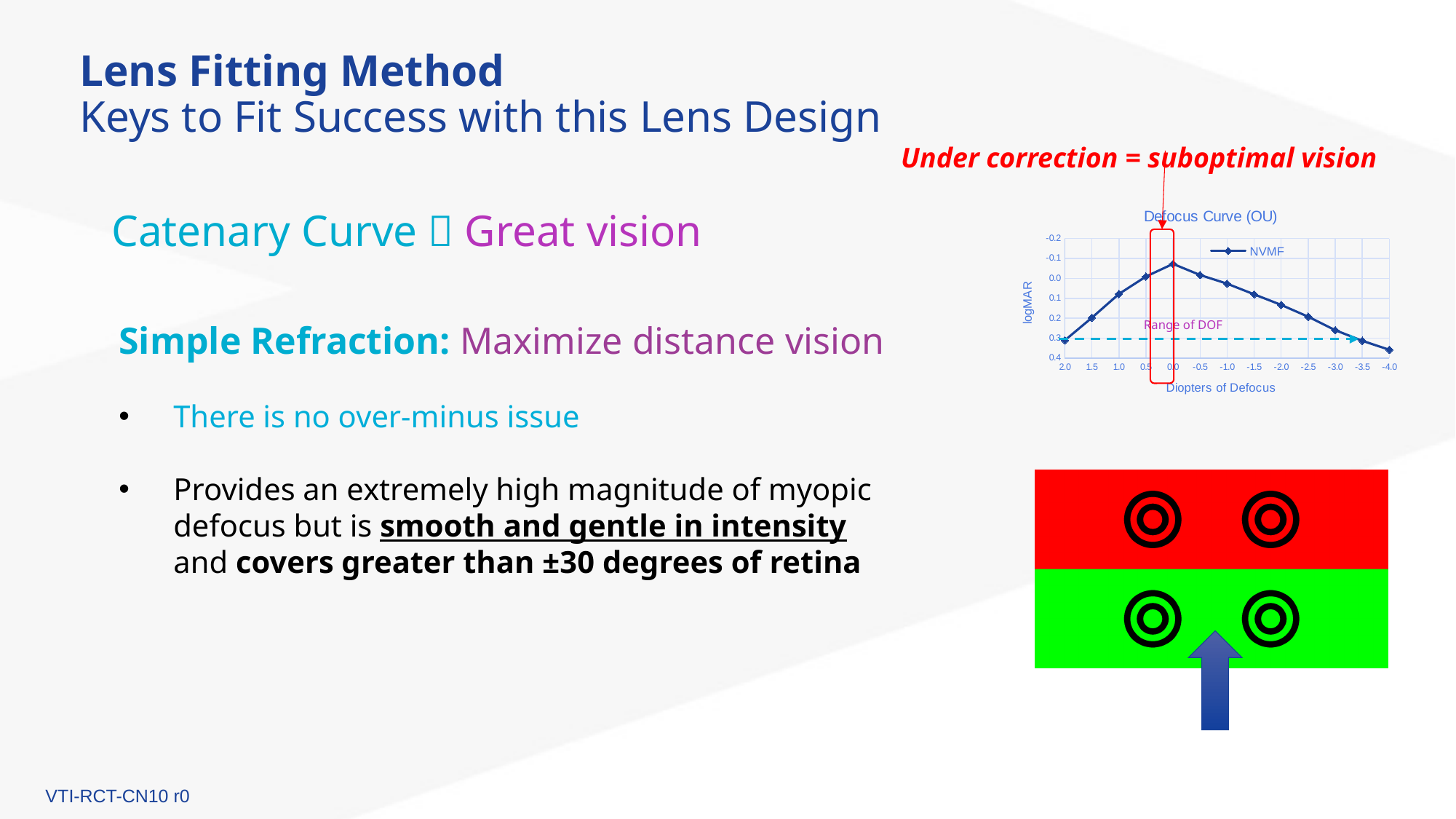
Which has the larger logMAR value on the NVMF line: -1.0 or -3.0 diopters of defocus? -3.0 What is the name of the series plotted in the Defocus Curve (OU) chart? NVMF Is the logMAR value for NVMF at 1.0 diopters of defocus greater or less than 0.2? less Do the NVMF logMAR values rise or fall as the x axis moves from 2.0 to 0.0 diopters of defocus? fall Is the logMAR value for NVMF at -4.0 diopters of defocus greater or less than 0.2? greater At which diopters of defocus does the NVMF line reach its lowest logMAR value? 0.0 What is the x-axis label of the Defocus Curve (OU) chart? Diopters of Defocus What kind of chart is the Defocus Curve (OU) chart? line chart How many series does the legend of the Defocus Curve (OU) chart list? 1 Is the logMAR value for NVMF at 0.0 diopters of defocus greater or less than 0.0? less How many data points are plotted on the NVMF line in the Defocus Curve (OU) chart? 13